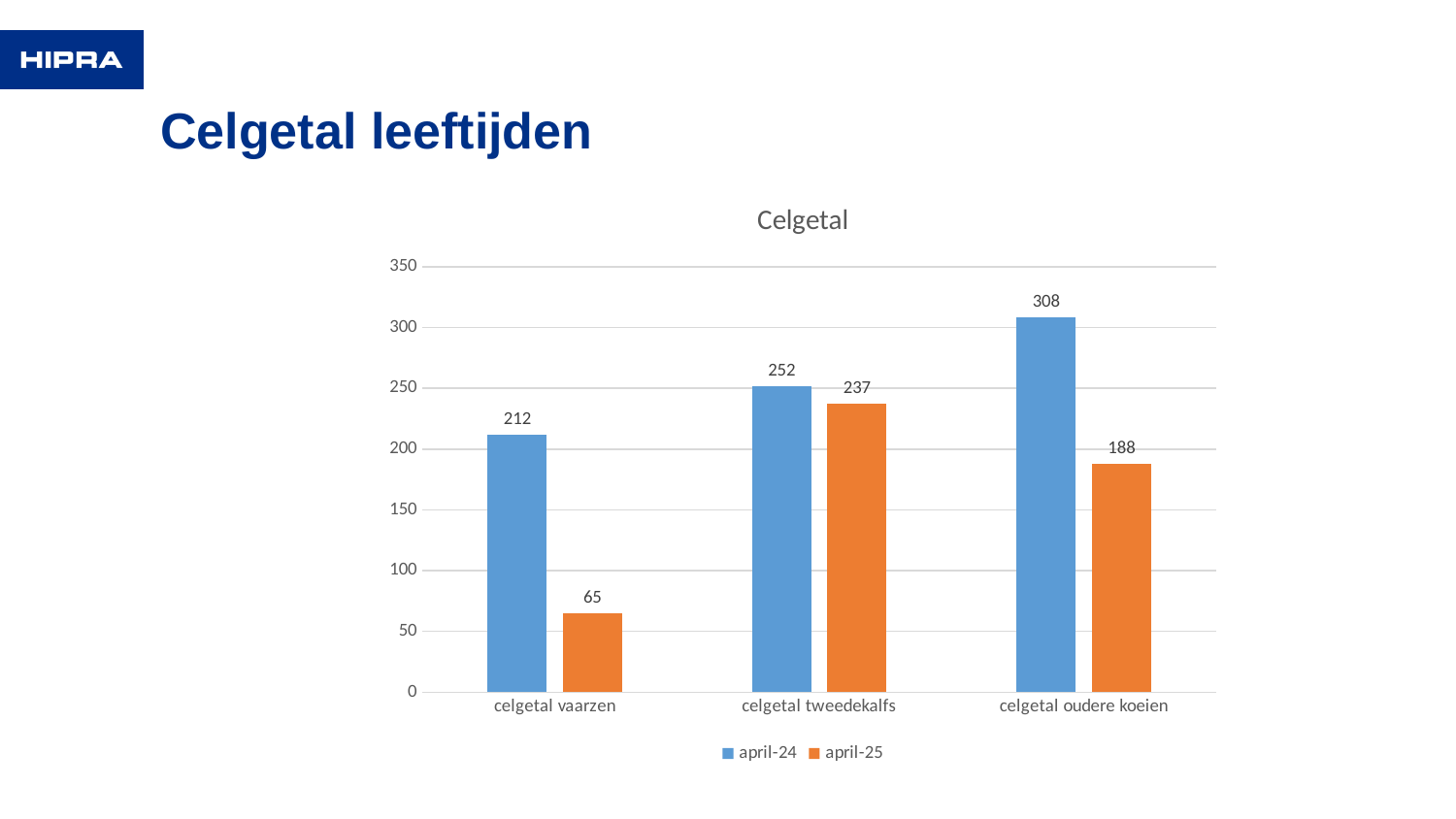
What kind of chart is shown on the slide? bar chart What is the difference between the april-24 and april-25 values for celgetal oudere koeien? 120 How many series does the legend list? 2 What is the april-24 value for celgetal vaarzen? 212 What is the april-25 value for celgetal oudere koeien? 188 What is the difference between the april-24 and april-25 values for celgetal vaarzen? 147 Which category has the lowest april-25 value? celgetal vaarzen What is the april-25 value for celgetal tweedekalfs? 237 What is the title of the chart? Celgetal Which category has the highest april-24 value? celgetal oudere koeien Which is larger for celgetal tweedekalfs, the april-24 value or the april-25 value? april-24 How many categories are shown on the x axis? 3